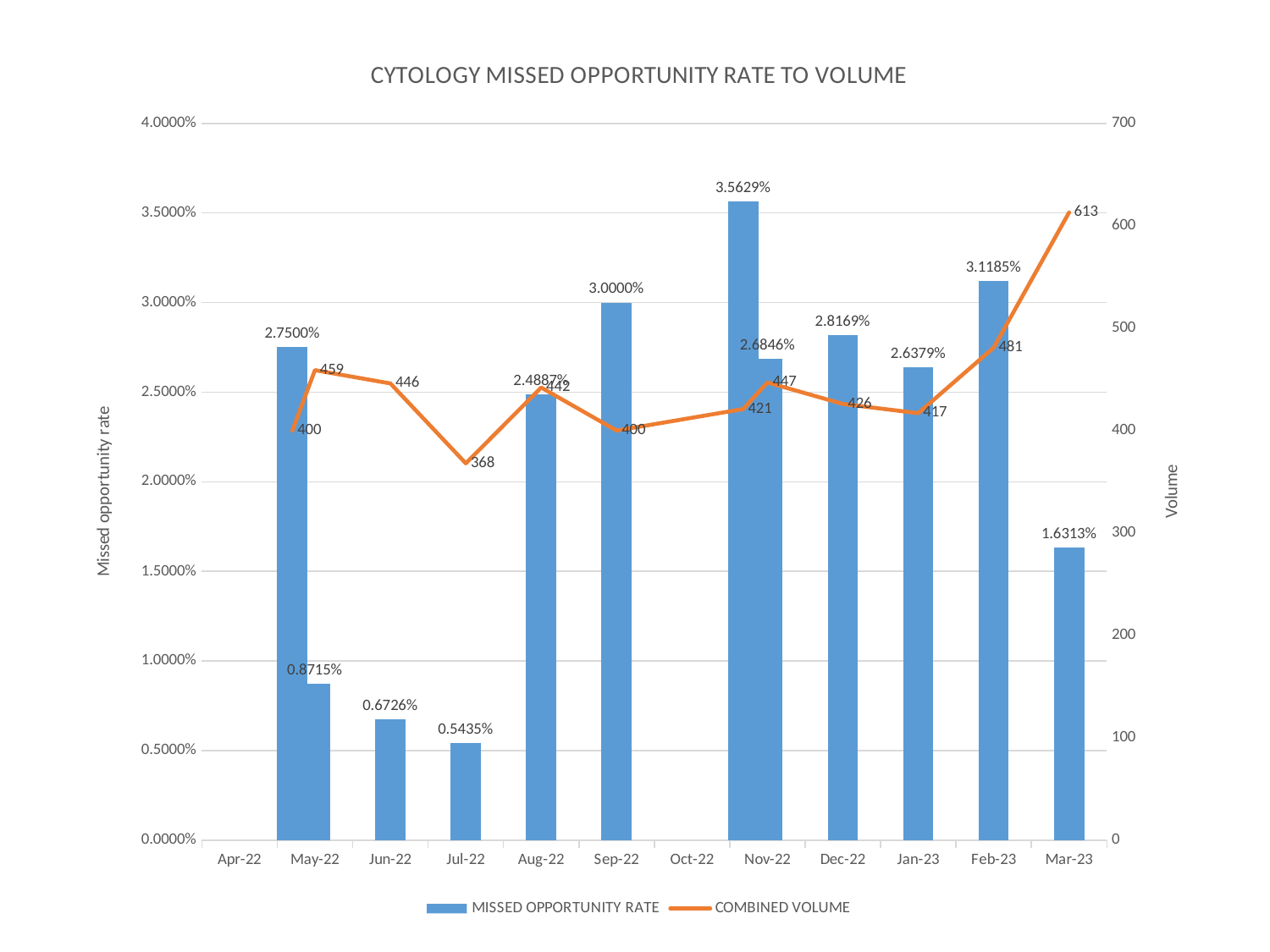
Which month has the highest combined volume? Mar-23 What is the highest missed opportunity rate value shown on the chart? 3.5629% How many months are shown on the x axis? 12 How many series does the legend list? 2 What is the missed opportunity rate for Jul-22? 0.5435% What is the difference in combined volume between Mar-23 and Feb-23? 132 What is the missed opportunity rate for Feb-23? 3.1185% What is the combined volume for Jul-22? 368 Which month has the lowest missed opportunity rate? Jul-22 What kind of chart is shown on the slide? A combination bar and line chart Which has the higher missed opportunity rate, Dec-22 or Jan-23? Dec-22 What is the combined volume for Mar-23? 613